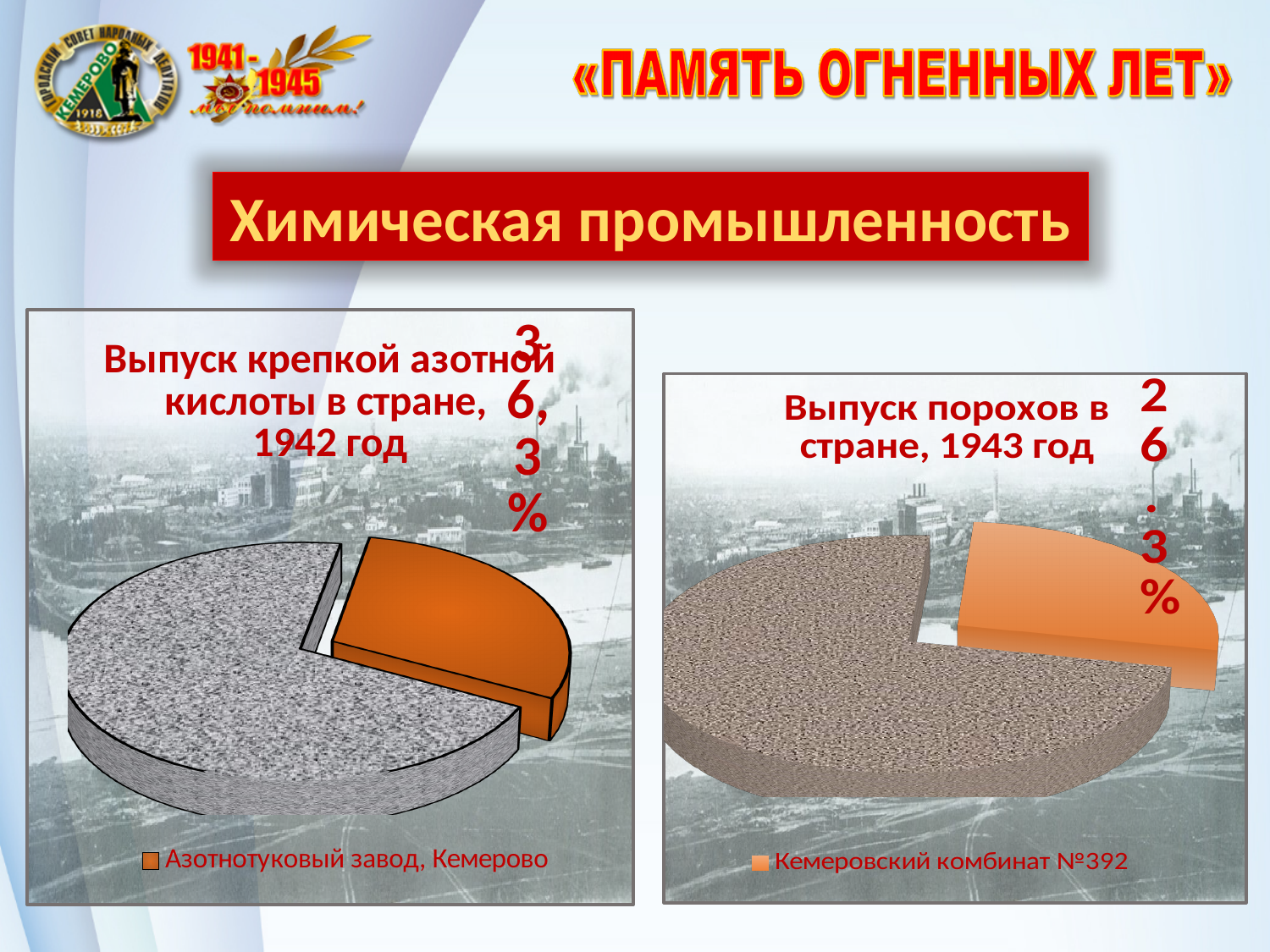
What is the legend entry of the left chart, 'Выпуск крепкой азотной кислоты в стране, 1942 год'? Азотнотуковый завод, Кемерово In the left chart, is the labelled share of the orange slice greater or less than 50%? less What is the legend entry of the right chart, 'Выпуск порохов в стране, 1943 год'? Кемеровский комбинат №392 What kind of chart is shown in the right chart, 'Выпуск порохов в стране, 1943 год'? Pie chart In the left chart, 'Выпуск крепкой азотной кислоты в стране, 1942 год', what share is labelled for the orange slice (Азотнотуковый завод, Кемерово)? 36,3% In the right chart, 'Выпуск порохов в стране, 1943 год', what share is labelled for the orange slice (Кемеровский комбинат №392)? 26.3% In the right chart, what value is printed as the data label on the pie? 26.3% In the left chart, what value is printed as the data label on the pie? 36,3% Which is larger: the labelled share in the left chart (1942 nitric acid) or the labelled share in the right chart (1943 gunpowder)? The left chart (36,3%) By how many percentage points does the labelled share in the left chart (36,3%) exceed the labelled share in the right chart (26.3%)? 10 percentage points How many entries does the legend of the left chart list? 1 What kind of chart is shown in the left chart, 'Выпуск крепкой азотной кислоты в стране, 1942 год'? Pie chart